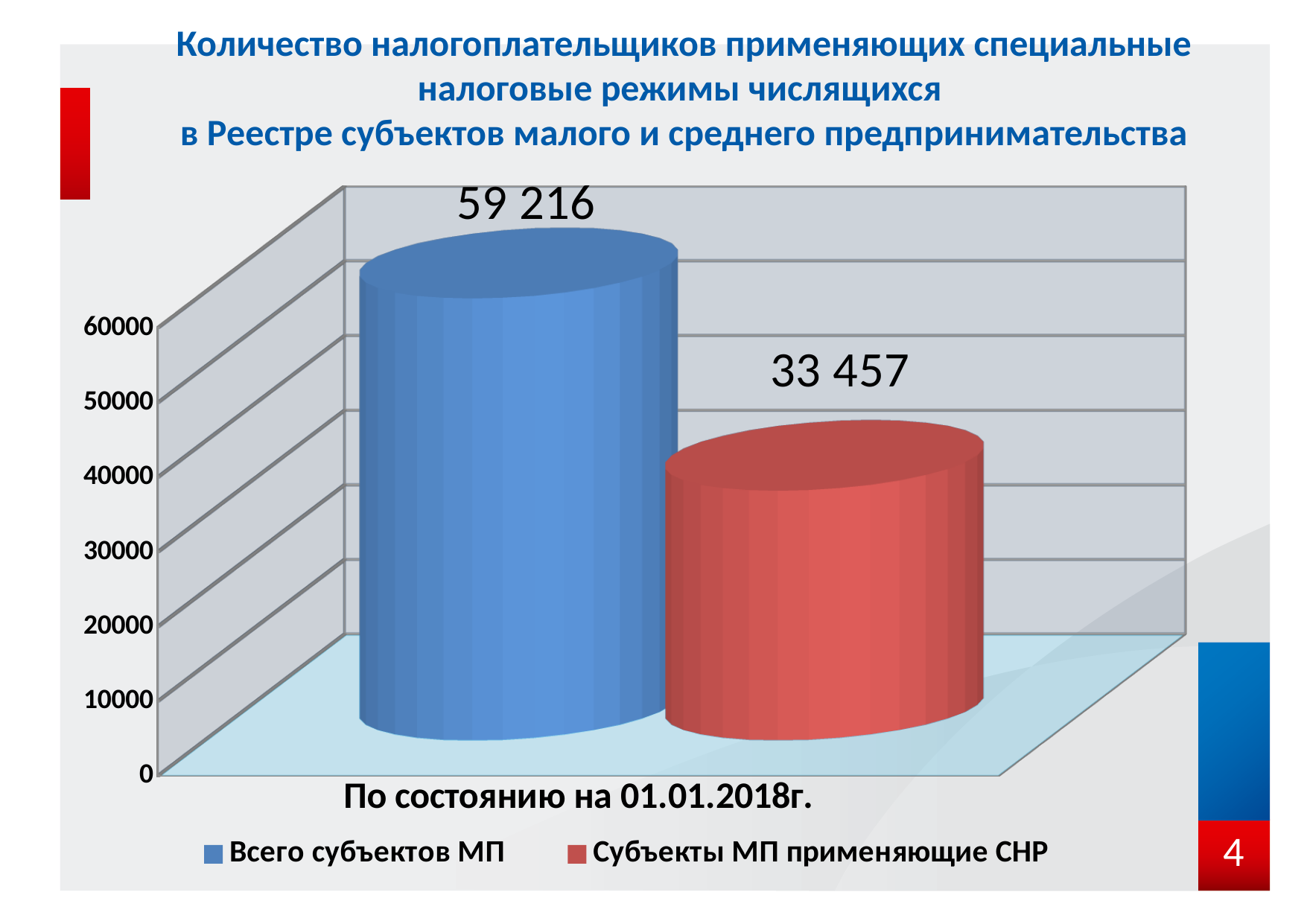
What colour is the bar for "Субъекты МП применяющие СНР"? Red Which series has the highest value on the chart? Всего субъектов МП What is the category label shown on the x axis of the chart? По состоянию на 01.01.2018г. What kind of chart is shown on the slide? Bar chart Which series has the higher value, "Всего субъектов МП" or "Субъекты МП применяющие СНР"? Всего субъектов МП What is the value for "Субъекты МП применяющие СНР"? 33 457 Is the value for "Всего субъектов МП" greater or less than 50000? greater What is the difference between the value for "Всего субъектов МП" and the value for "Субъекты МП применяющие СНР"? 25 759 Which series has the lowest value on the chart? Субъекты МП применяющие СНР How many series does the legend list? 2 Is the value for "Субъекты МП применяющие СНР" greater or less than 40000? less What is the value for "Всего субъектов МП"? 59 216